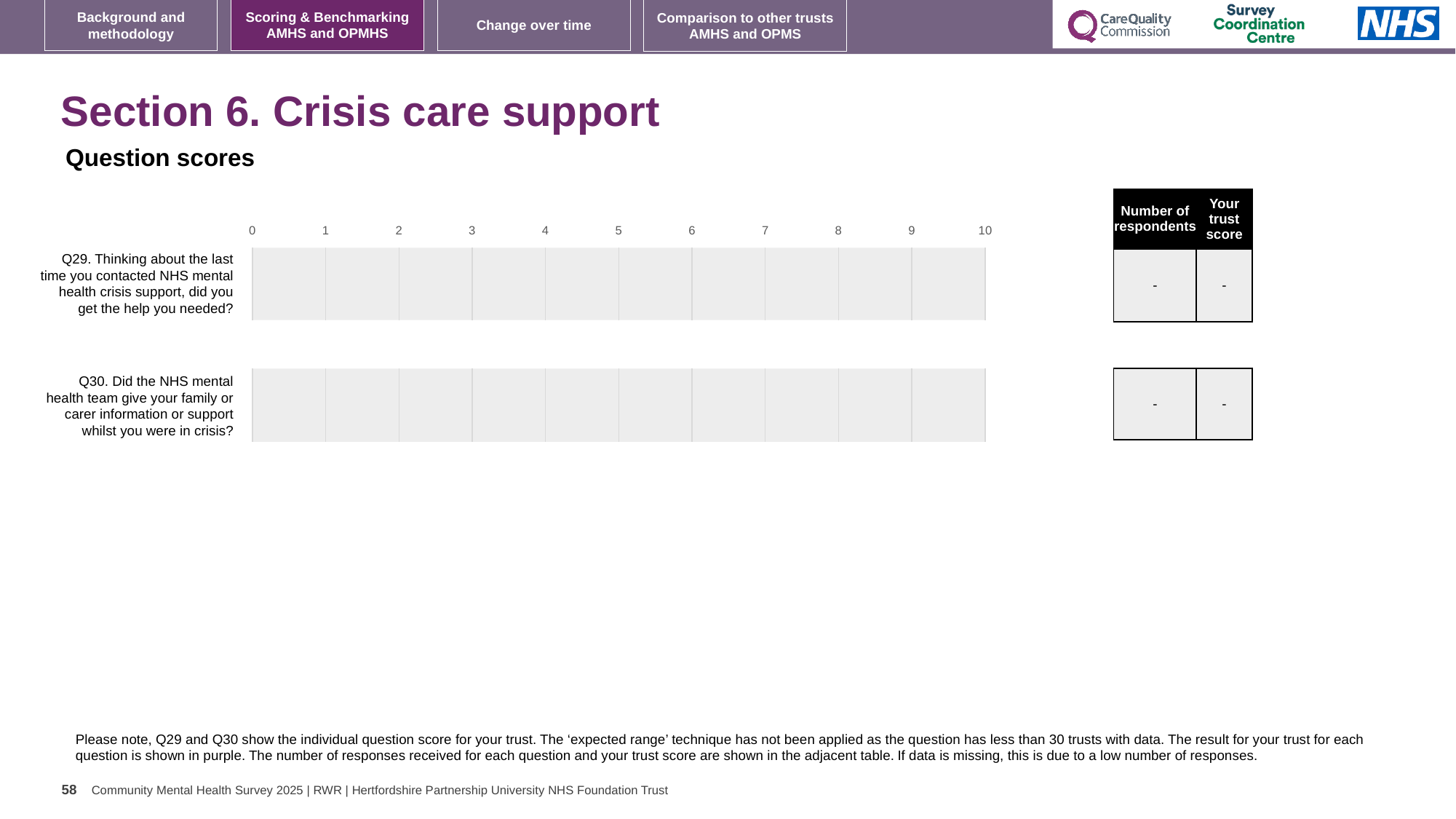
What is the highest value shown on the chart's horizontal axis? 10 What is the number of respondents shown in the table for Q29? - What is the lowest value shown on the chart's horizontal axis? 0 Which question number appears first (at the top) on the chart? Q29 How many questions (categories) are listed on the chart? 2 What is the trust score shown in the table for Q30? - Are any bars plotted for Q29 or Q30 on the chart? No